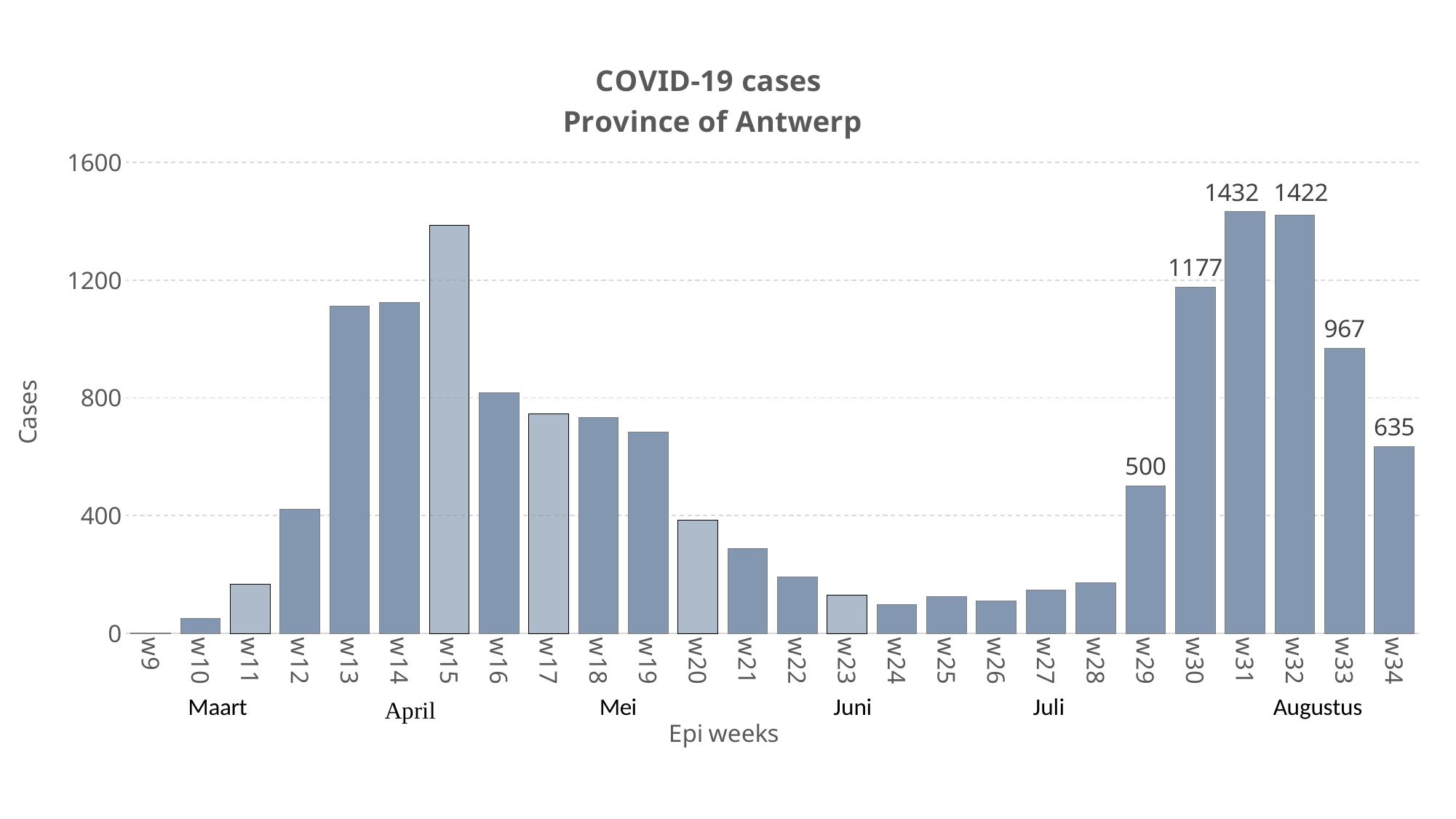
How many cases are shown for w34? 635 How many cases are shown for w33? 967 Which week has more cases, w13 or w16? w13 What is the title of the chart? COVID-19 cases Province of Antwerp What is the difference in cases between w31 and w32? 10 How many cases are shown for w31? 1432 What is the difference in cases between w30 and w29? 677 Which week has the highest number of cases? w31 Which week has the lowest number of cases? w9 What type of chart is shown on the slide? bar chart How many cases are shown for w29? 500 Is the value for w15 greater or less than 1200? greater